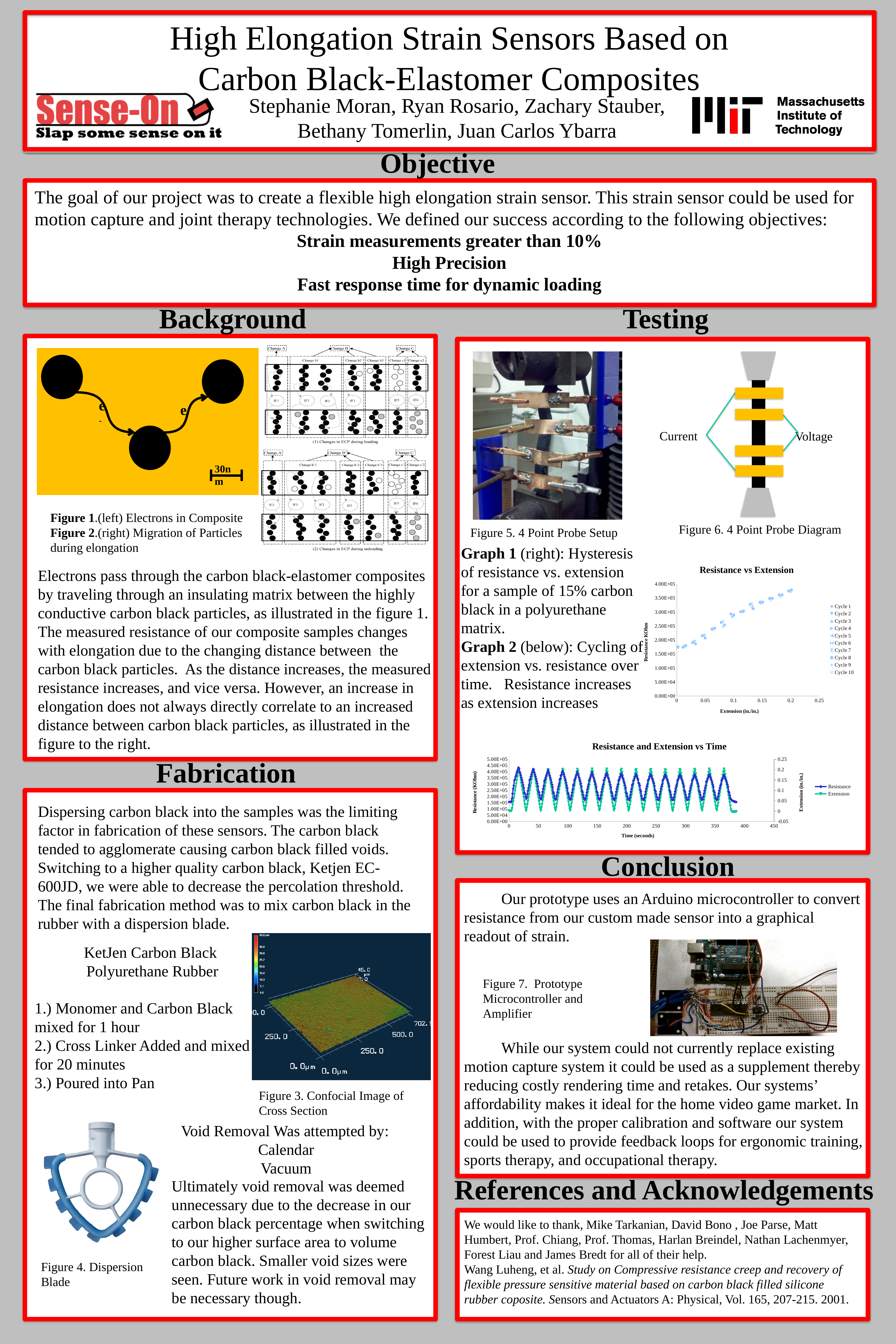
In the "Resistance vs Extension" chart, does resistance rise or fall as extension increases? rise How many series does the legend of the "Resistance vs Extension" chart list? 10 In the "Resistance and Extension vs Time" chart, are the peak resistance values greater or less than 5.00E+05? less What are the two series named in the legend of the "Resistance and Extension vs Time" chart? Resistance and Extension What is the x-axis label of the "Resistance vs Extension" chart? Extension (in./in.) How many series does the legend of the "Resistance and Extension vs Time" chart list? 2 In the "Resistance vs Extension" chart, is the resistance at an extension of 0 greater or less than 2.00E+05? less What kind of chart is the "Resistance vs Extension" chart? scatter chart What kind of chart is the "Resistance and Extension vs Time" chart? line chart In the "Resistance and Extension vs Time" chart, is the highest time tick on the x axis greater or less than 400? greater